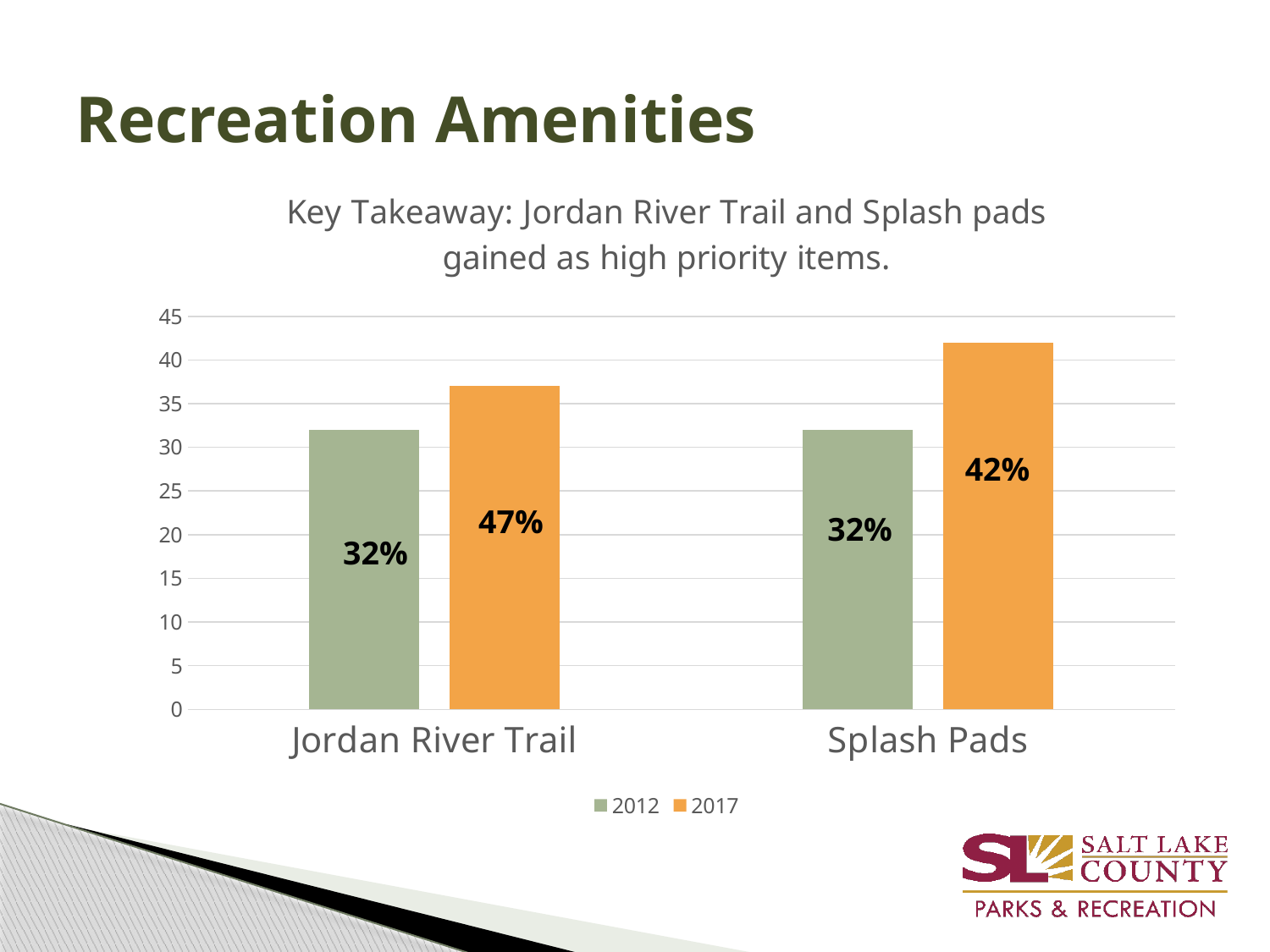
What is the value for Splash Pads in 2012? 32% How many categories are shown on the x axis? 2 Is the value for Jordan River Trail in 2012 greater or less than 35? less What kind of chart is shown on the slide? Bar chart For Splash Pads, which year has the larger value, 2012 or 2017? 2017 What is the value for Jordan River Trail in 2012? 32% What is the value for Jordan River Trail in 2017? 47% Is the value for Splash Pads in 2017 greater or less than 40? greater How many series does the legend list? 2 What is the value for Splash Pads in 2017? 42% For Jordan River Trail, which year has the larger value, 2012 or 2017? 2017 What is the difference between the 2017 and 2012 values for Splash Pads? 10 percentage points